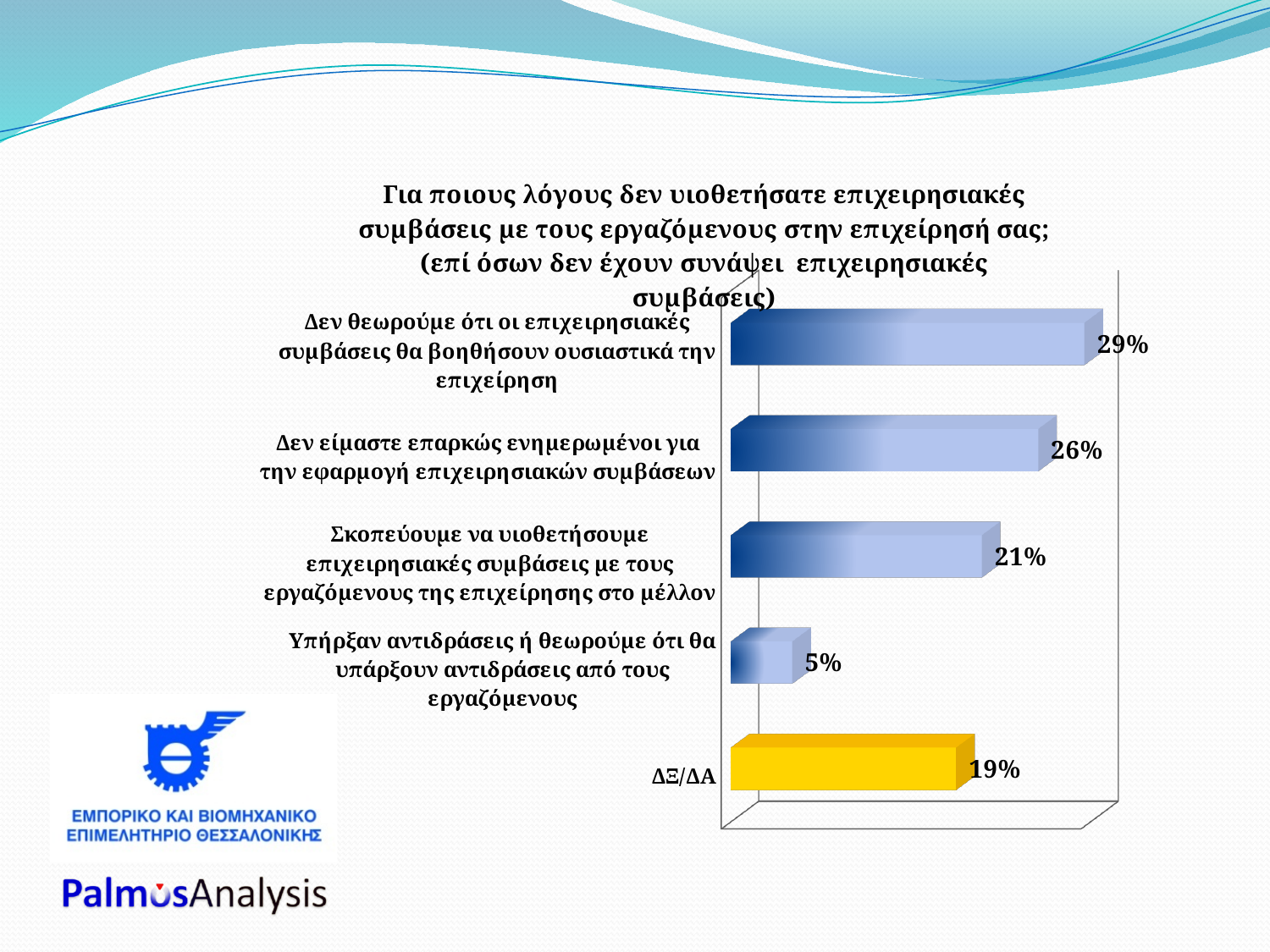
Which is larger: the value for 'Σκοπεύουμε να υιοθετήσουμε επιχειρησιακές συμβάσεις με τους εργαζόμενους της επιχείρησης στο μέλλον' or the value for ΔΞ/ΔΑ? Σκοπεύουμε να υιοθετήσουμε επιχειρησιακές συμβάσεις με τους εργαζόμενους της επιχείρησης στο μέλλον What kind of chart is shown on the slide? Bar chart What is the value for 'Υπήρξαν αντιδράσεις ή θεωρούμε ότι θα υπάρξουν αντιδράσεις από τους εργαζόμενους'? 5% What is the value for 'Δεν θεωρούμε ότι οι επιχειρησιακές συμβάσεις θα βοηθήσουν ουσιαστικά την επιχείρηση'? 29% What is the difference between the values for 'Δεν θεωρούμε ότι οι επιχειρησιακές συμβάσεις θα βοηθήσουν ουσιαστικά την επιχείρηση' and ΔΞ/ΔΑ? 10% What is the value for 'Σκοπεύουμε να υιοθετήσουμε επιχειρησιακές συμβάσεις με τους εργαζόμενους της επιχείρησης στο μέλλον'? 21% What is the value for ΔΞ/ΔΑ? 19% Which category has the lowest value? Υπήρξαν αντιδράσεις ή θεωρούμε ότι θα υπάρξουν αντιδράσεις από τους εργαζόμενους Which category has the highest value? Δεν θεωρούμε ότι οι επιχειρησιακές συμβάσεις θα βοηθήσουν ουσιαστικά την επιχείρηση How many categories are shown in the chart? 5 Which bar is coloured yellow instead of blue? ΔΞ/ΔΑ What is the value for 'Δεν είμαστε επαρκώς ενημερωμένοι για την εφαρμογή επιχειρησιακών συμβάσεων'? 26%